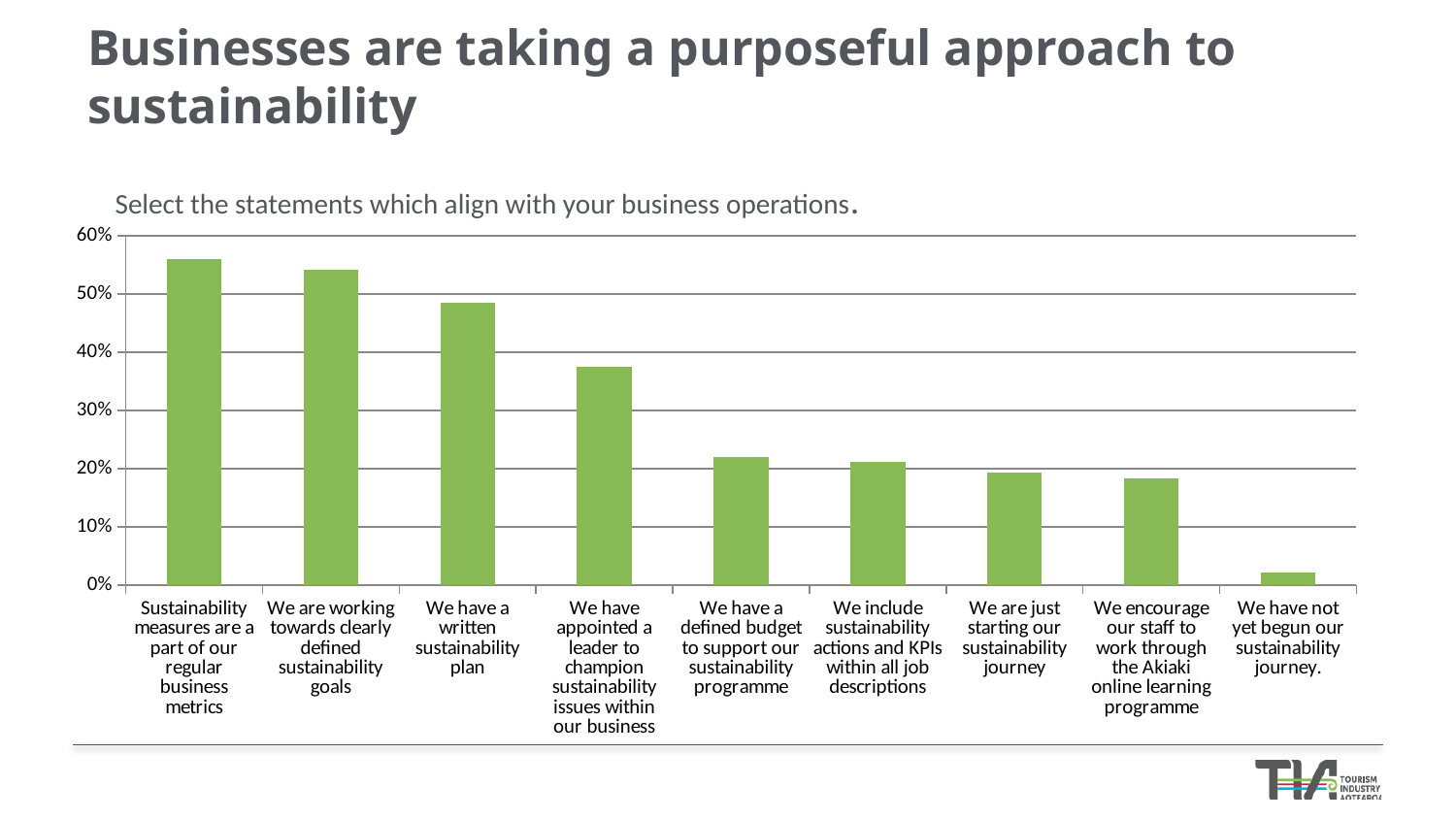
Is the value for 'We are working towards clearly defined sustainability goals' greater or less than 50%? greater Which is larger: the value for 'We have a written sustainability plan' or the value for 'We have appointed a leader to champion sustainability issues within our business'? We have a written sustainability plan Do the bar values generally rise or fall moving from left to right along the x axis? fall Is the value for 'We have not yet begun our sustainability journey.' greater or less than 10%? less What survey question is shown above the chart? Select the statements which align with your business operations. Which statement has the lowest value on the chart? We have not yet begun our sustainability journey. Is the value for 'We have a defined budget to support our sustainability programme' greater or less than 30%? less What kind of chart is shown on the slide? bar chart How many statements (categories) are plotted on the chart? 9 Which statement has the highest value on the chart? Sustainability measures are a part of our regular business metrics